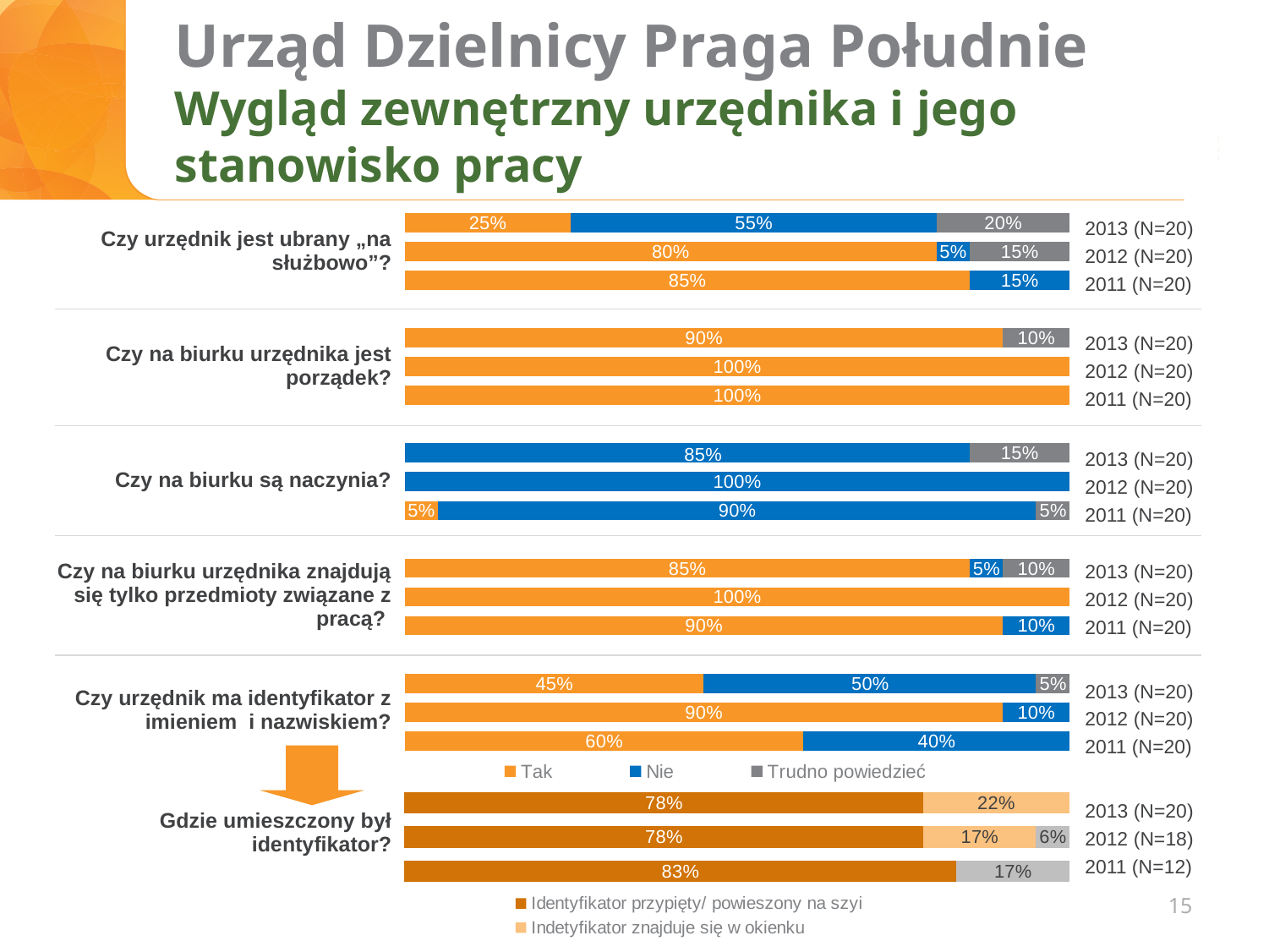
In the chart "Gdzie umieszczony był identyfikator?", what is the sample size (N) for 2012? N=18 In the chart "Gdzie umieszczony był identyfikator?", what percentage had the identifier pinned/hung on the neck in 2011? 83% In the chart "Czy na biurku są naczynia?", what percentage answered "Nie" in 2011? 90% How many series does the legend list for the chart "Czy urzędnik ma identyfikator z imieniem i nazwiskiem?"? 3 In the chart "Czy na biurku urzędnika znajdują się tylko przedmioty związane z pracą?", what is the difference between the "Tak" share in 2012 and in 2013? 15% In the chart "Czy urzędnik jest ubrany „na służbowo”?", what percentage answered "Tak" in 2013? 25% In the chart "Czy urzędnik ma identyfikator z imieniem i nazwiskiem?", what percentage answered "Nie" in 2011? 40% In the chart "Czy na biurku urzędnika jest porządek?", what is the "Trudno powiedzieć" share in 2013? 10% In the chart "Czy urzędnik ma identyfikator z imieniem i nazwiskiem?", is the "Tak" share larger in 2012 or in 2013? 2012 What type of chart is used on this slide? Stacked bar chart In the chart "Czy urzędnik jest ubrany „na służbowo”?", which year has the highest "Tak" share? 2011 In the chart "Czy urzędnik jest ubrany „na służbowo”?", what percentage answered "Nie" in 2013? 55%